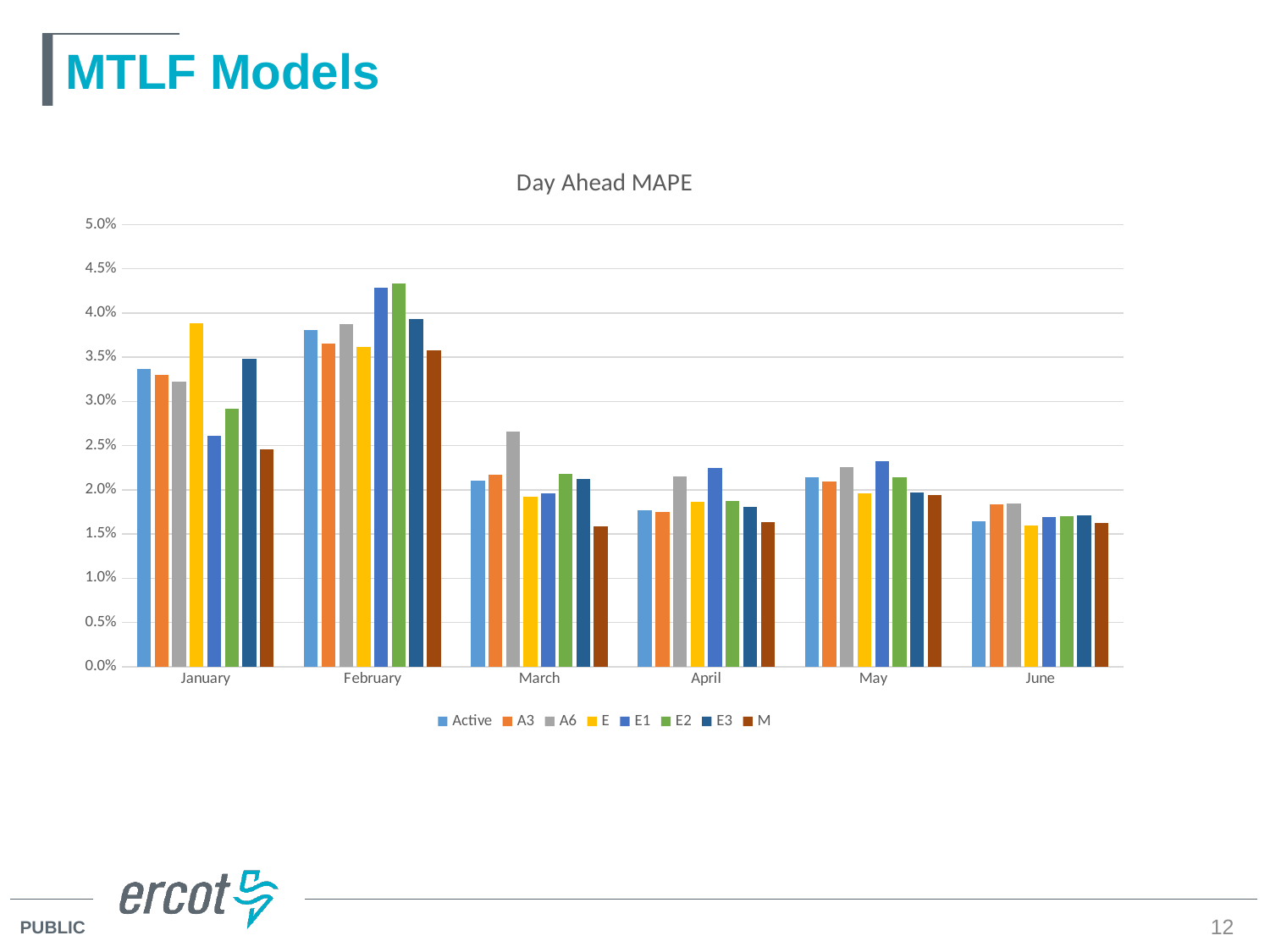
Which series has the highest value in January? E What is the title of the chart? Day Ahead MAPE Is the value for A6 in March greater or less than 2.5%? greater In February, which is larger, the value for E2 or the value for M? E2 Is the value for E in January greater or less than 3.5%? greater Is the value for M in June greater or less than 2.0%? less How many series does the legend list? 8 From February to April, does the Active series rise or fall? fall In which month is the E1 value highest? February How many months are shown on the x axis? 6 Which series has the lowest value in March? M What kind of chart is shown on the slide? bar chart